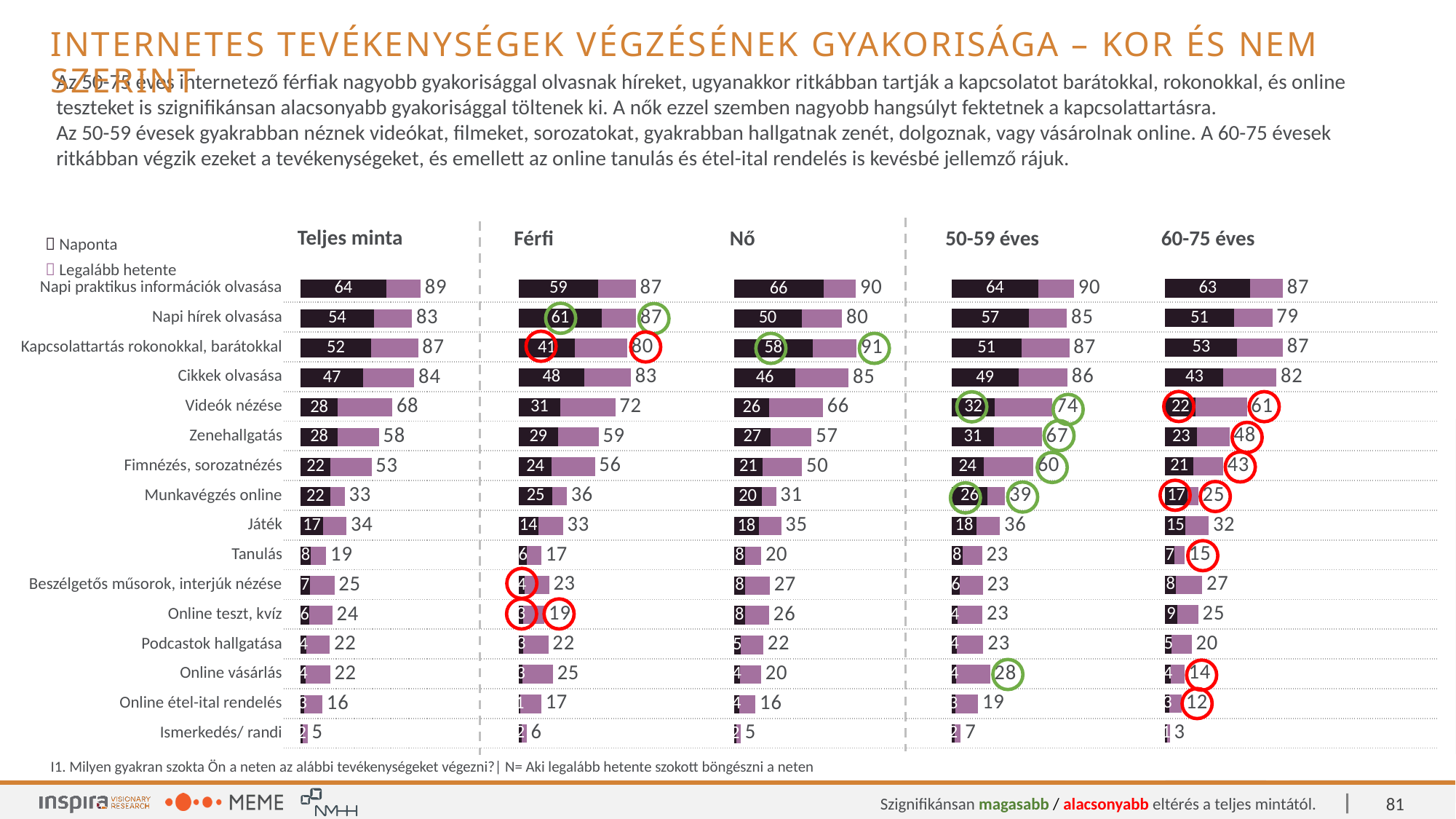
For Zenehallgatás, which chart shows the larger Legalább hetente value: 50-59 éves or 60-75 éves? 50-59 éves In the Teljes minta chart, which category has the lowest Legalább hetente value? Ismerkedés/ randi In the 50-59 éves chart, what is the difference between the Legalább hetente and Naponta values for Videók nézése? 42 In the 60-75 éves chart, what is the Legalább hetente value for Videók nézése? 61 How many activity categories are listed in each chart? 16 In the Nő chart, what is the Legalább hetente value for Kapcsolattartás rokonokkal, barátokkal? 91 In the Teljes minta chart, what is the Legalább hetente value for Kapcsolattartás rokonokkal, barátokkal? 87 In the Férfi chart, what is the Naponta value for Napi hírek olvasása? 61 What kind of chart is used to show the data on this slide? Bar chart In the Nő chart, which category has the highest Legalább hetente value? Kapcsolattartás rokonokkal, barátokkal How many series does the legend list? 2 For Kapcsolattartás rokonokkal, barátokkal, how much higher is the Legalább hetente value in the Nő chart than in the Férfi chart? 11